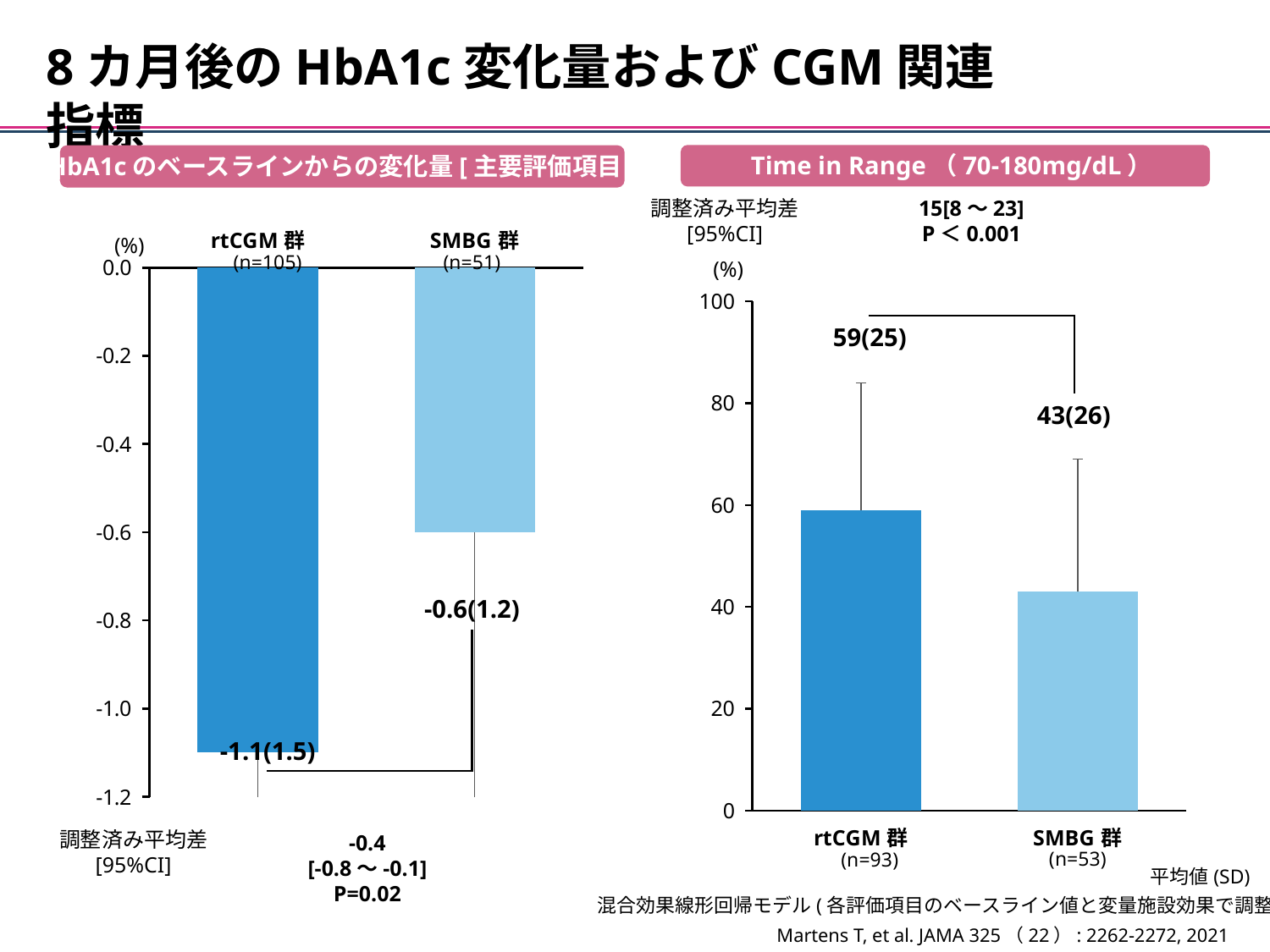
In the HbA1c change-from-baseline chart on the left, what is the P value shown below the chart? P=0.02 In the Time in Range (70-180mg/dL) chart, what is the data label on the SMBG群 bar? 43(26) How many bars are plotted in the Time in Range (70-180mg/dL) chart? 2 In the Time in Range (70-180mg/dL) chart, is the value for SMBG群 greater or less than 60? less In the Time in Range (70-180mg/dL) chart, what is the data label on the rtCGM群 bar? 59(25) In the Time in Range (70-180mg/dL) chart, what is the difference between the mean values of the rtCGM群 and SMBG群 bars (59 and 43)? 16 What kind of chart is the HbA1c change-from-baseline chart on the left? Bar chart In the HbA1c change-from-baseline chart on the left, what is the data label on the SMBG群 bar? -0.6(1.2) In the HbA1c change-from-baseline chart on the left, what is the data label on the rtCGM群 bar? -1.1(1.5) In the HbA1c change-from-baseline chart on the left, which group shows the larger decrease in HbA1c? rtCGM群 In the Time in Range (70-180mg/dL) chart, what is the adjusted mean difference [95%CI] shown above the chart? 15[8～23] In the Time in Range (70-180mg/dL) chart, which group has the higher bar? rtCGM群